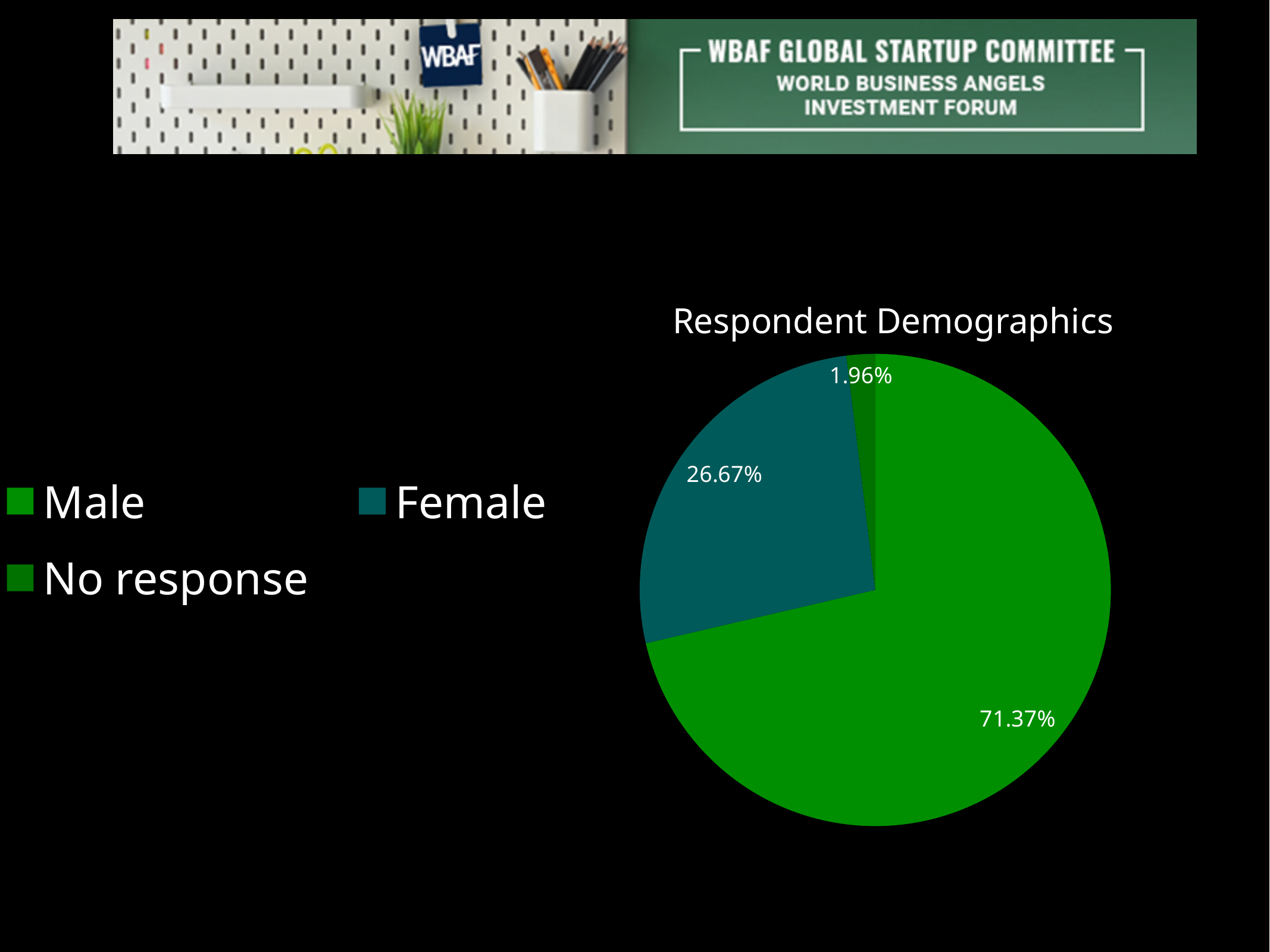
What percentage of respondents are Male? 71.37% What is the difference in percentage points between the Male and Female shares? 44.7 How many categories does the pie chart show? 3 What is the title of the chart? Respondent Demographics What is the difference in percentage points between the Female and No response shares? 24.71 What type of chart is shown on the slide? Pie chart How many entries does the legend list? 3 What percentage of respondents gave No response? 1.96% Which is larger, the Female share or the No response share? Female What percentage of respondents are Female? 26.67% Which category has the smallest share of the pie? No response Which category has the largest share of the pie? Male